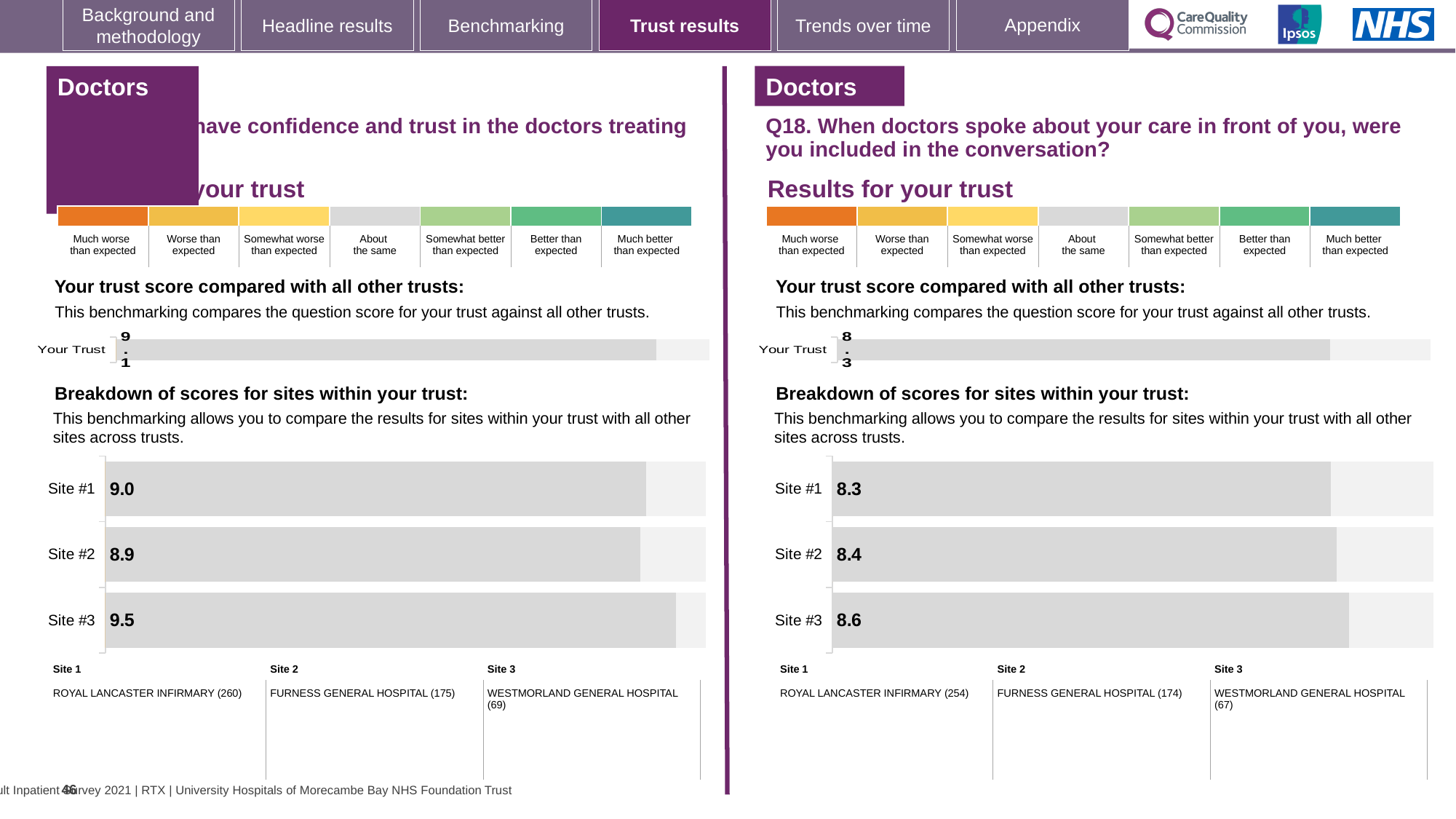
In the site breakdown chart on the left side of the slide, what is the score for Site #3? 9.5 In the Q18 site breakdown chart on the right side of the slide, what is the score for Site #1? 8.3 In the Q18 site breakdown chart on the right side of the slide, which site has the highest score? Site #3 In the Q18 site breakdown chart on the right side of the slide, what is the difference between the scores for Site #3 and Site #1? 0.3 What kind of chart is used for the site breakdown on the right side of the slide? Bar chart In the site breakdown chart on the left side of the slide, which site has the lowest score? Site #2 In the Q18 site breakdown chart on the right side of the slide, what is the score for Site #3? 8.6 In the site breakdown chart on the left side of the slide, what is the difference between the scores for Site #3 and Site #2? 0.6 In the site breakdown chart on the left side of the slide, which site has the highest score? Site #3 In the Q18 site breakdown chart on the right side of the slide, is the score for Site #2 larger or smaller than the score for Site #1? Larger In the site breakdown chart on the left side of the slide, what is the score for Site #2? 8.9 In the Q18 site breakdown chart on the right side of the slide, how many sites are shown? 3